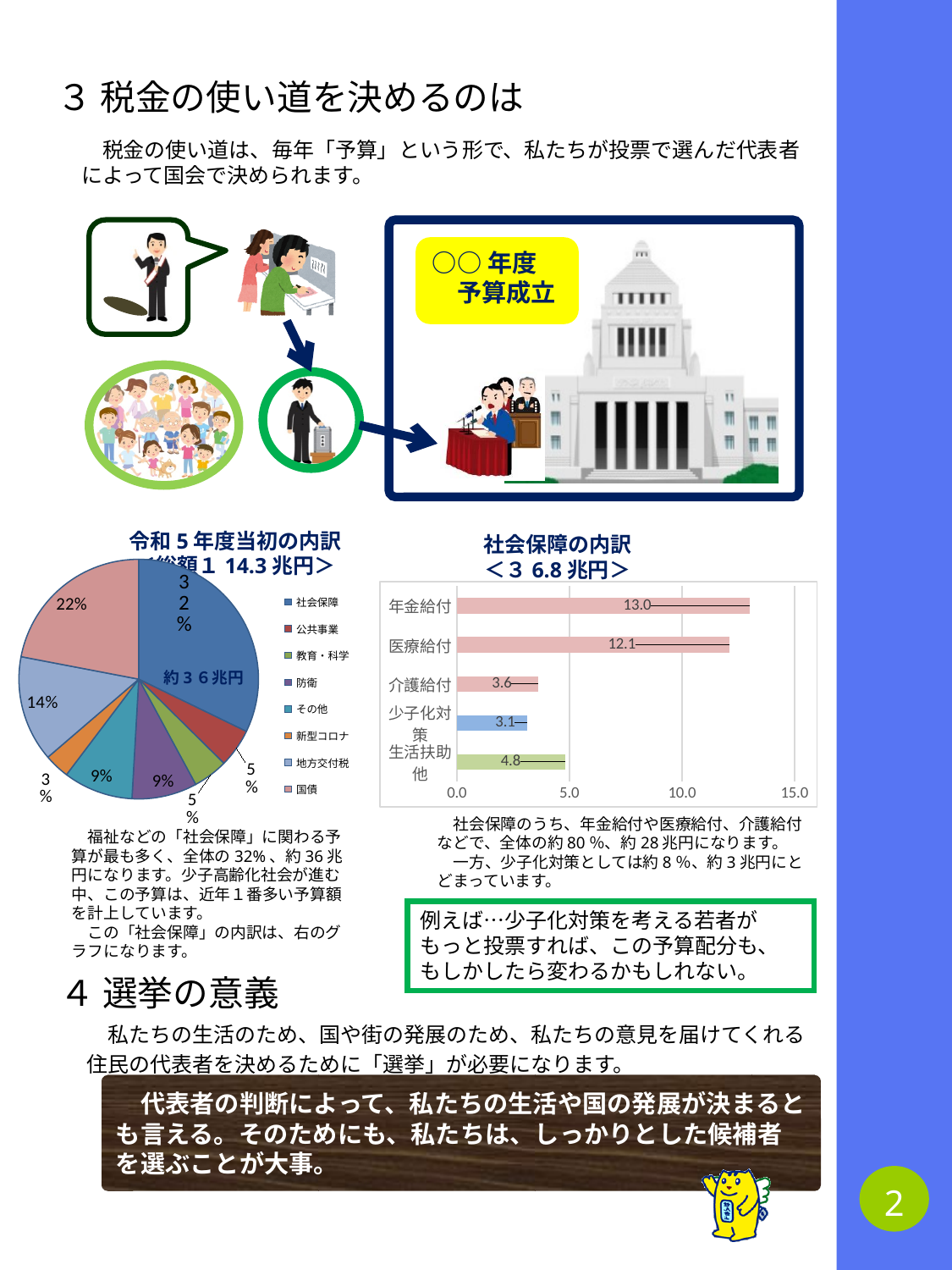
In the bar chart titled 社会保障の内訳, what is the difference between 年金給付 and 介護給付? 9.4 In the bar chart titled 社会保障の内訳, how many categories are shown? 5 What kind of chart is the one titled 社会保障の内訳? bar chart In the bar chart titled 社会保障の内訳, which category has the highest value? 年金給付 In the bar chart titled 社会保障の内訳, which is larger, 生活扶助他 or 介護給付? 生活扶助他 In the bar chart titled 社会保障の内訳, what is the value for 医療給付? 12.1 In the pie chart titled 令和5年度当初の内訳, what share does 国債 have? 22% In the pie chart titled 令和5年度当初の内訳, what share does 社会保障 have? 32% In the bar chart titled 社会保障の内訳, which category has the lowest value? 少子化対策 In the pie chart titled 令和5年度当初の内訳, how many entries does the legend list? 8 In the bar chart titled 社会保障の内訳, what is the value for 年金給付? 13.0 In the bar chart titled 社会保障の内訳, what is the value for 少子化対策? 3.1